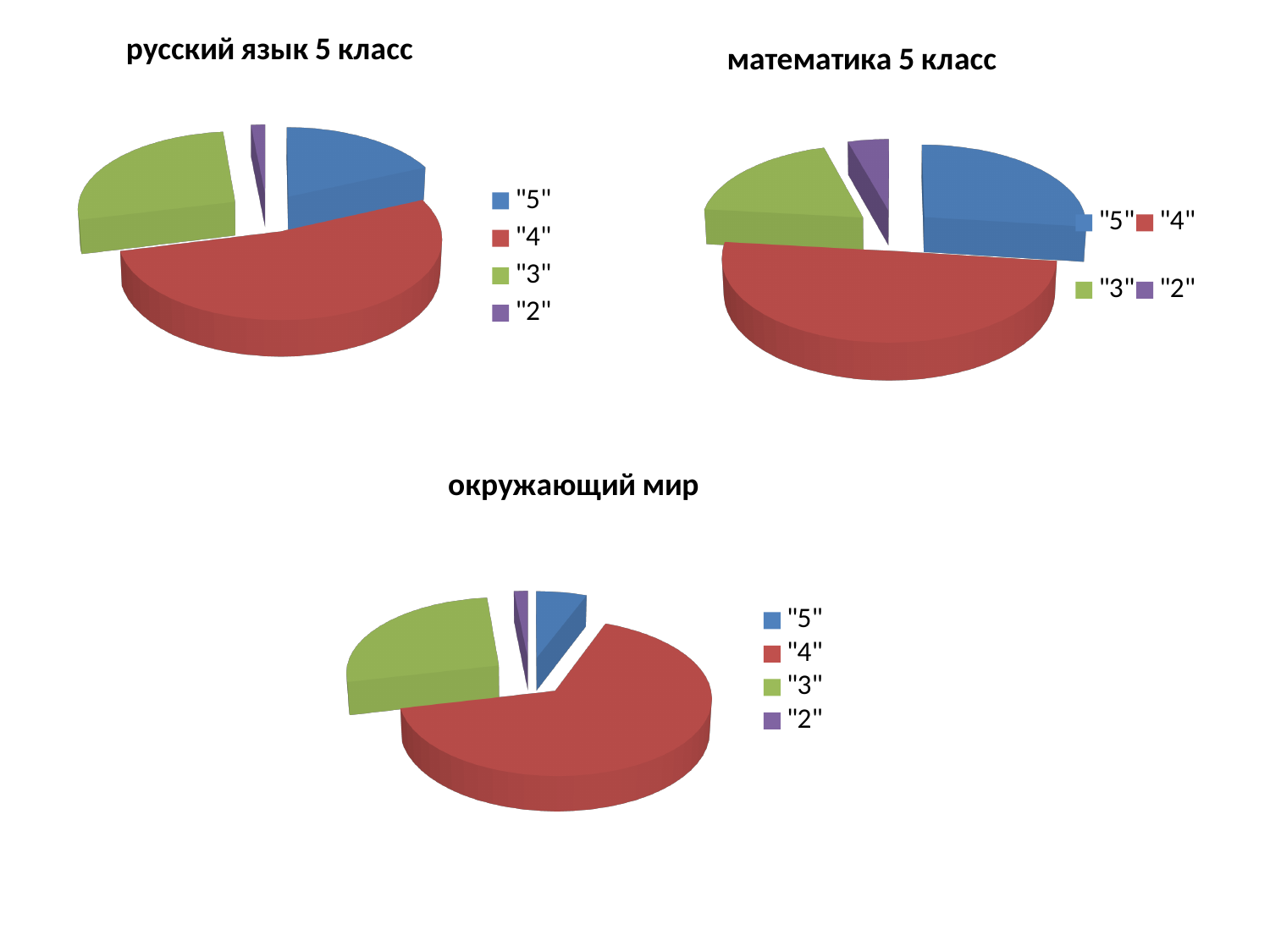
In the "математика 5 класс" chart, which slice is larger, "4" or "3"? "4" How many slices does the "окружающий мир" pie chart have? 4 What kind of chart is the "русский язык 5 класс" chart? pie chart In the "окружающий мир" chart, which slice is larger, "3" or "5"? "3" In the "математика 5 класс" chart, which grade has the smallest slice? "2" In the "окружающий мир" chart, which grade has the largest slice? "4" In the "русский язык 5 класс" chart, what colour is the slice for grade "3"? green How many entries does the legend of the "математика 5 класс" chart list? 4 In the "окружающий мир" chart, which slice is larger, "2" or "4"? "4" In the "русский язык 5 класс" chart, which grade has the smallest slice? "2" In the "русский язык 5 класс" chart, which grade has the largest slice? "4" What is the title of the chart at the bottom of the slide? окружающий мир